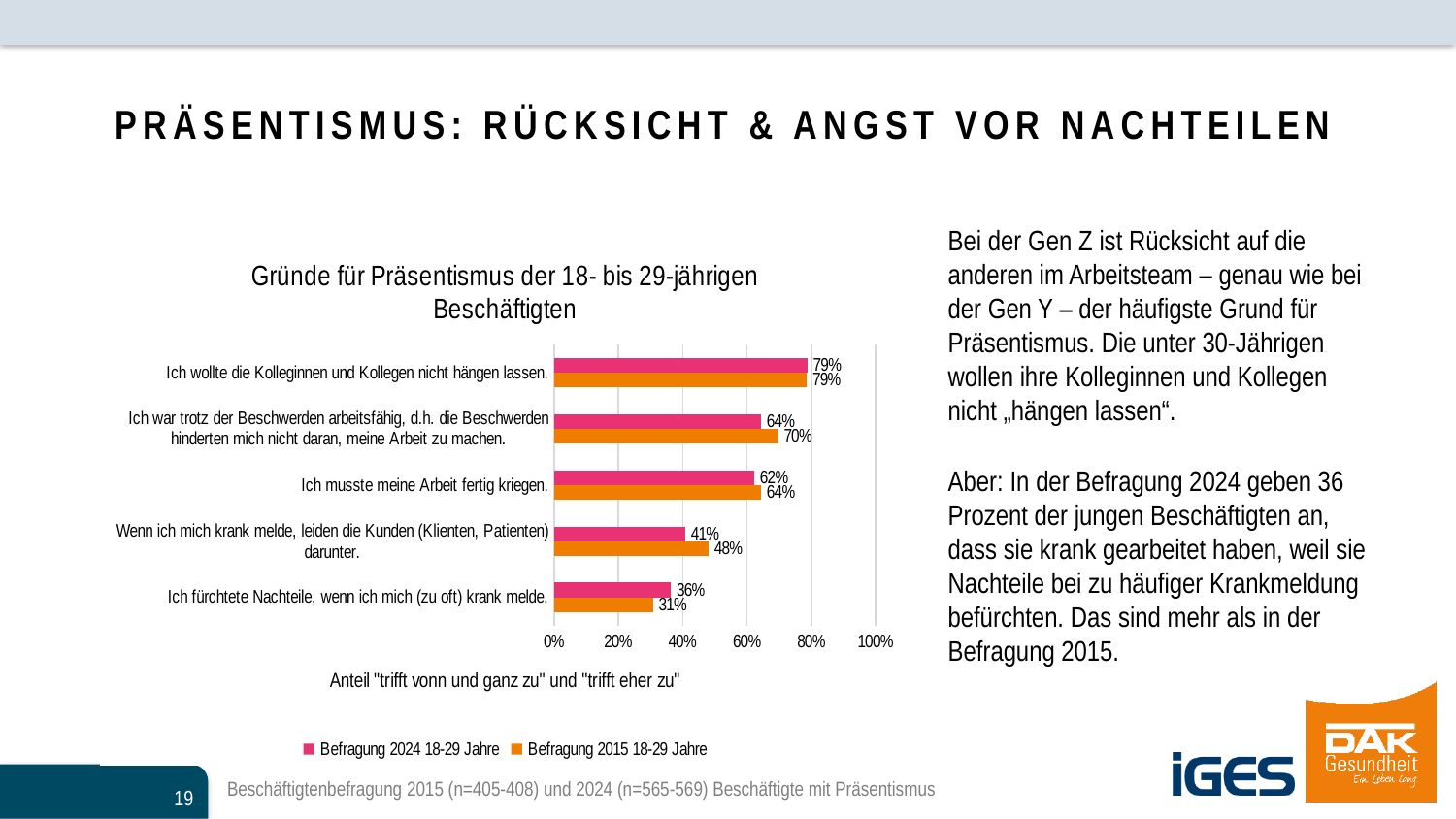
What is the value for "Ich war trotz der Beschwerden arbeitsfähig, d.h. die Beschwerden hinderten mich nicht daran, meine Arbeit zu machen." in the Befragung 2015 18-29 Jahre series? 70% Which category has the highest value in the Befragung 2024 18-29 Jahre series? Ich wollte die Kolleginnen und Kollegen nicht hängen lassen. What is the value for "Wenn ich mich krank melde, leiden die Kunden (Klienten, Patienten) darunter." in the Befragung 2024 18-29 Jahre series? 41% How many series does the legend list? 2 What is the value for "Ich fürchtete Nachteile, wenn ich mich (zu oft) krank melde." in the Befragung 2024 18-29 Jahre series? 36% What is the difference between the 2015 and 2024 values for "Wenn ich mich krank melde, leiden die Kunden (Klienten, Patienten) darunter."? 7% Which colour represents the Befragung 2015 18-29 Jahre series? orange What type of chart is shown on the slide? bar chart For "Ich fürchtete Nachteile, wenn ich mich (zu oft) krank melde.", which survey has the larger value, Befragung 2024 or Befragung 2015? Befragung 2024 18-29 Jahre Which category has the lowest value in the Befragung 2015 18-29 Jahre series? Ich fürchtete Nachteile, wenn ich mich (zu oft) krank melde. What is the title of the chart? Gründe für Präsentismus der 18- bis 29-jährigen Beschäftigten How many categories (reasons) are shown in the chart? 5